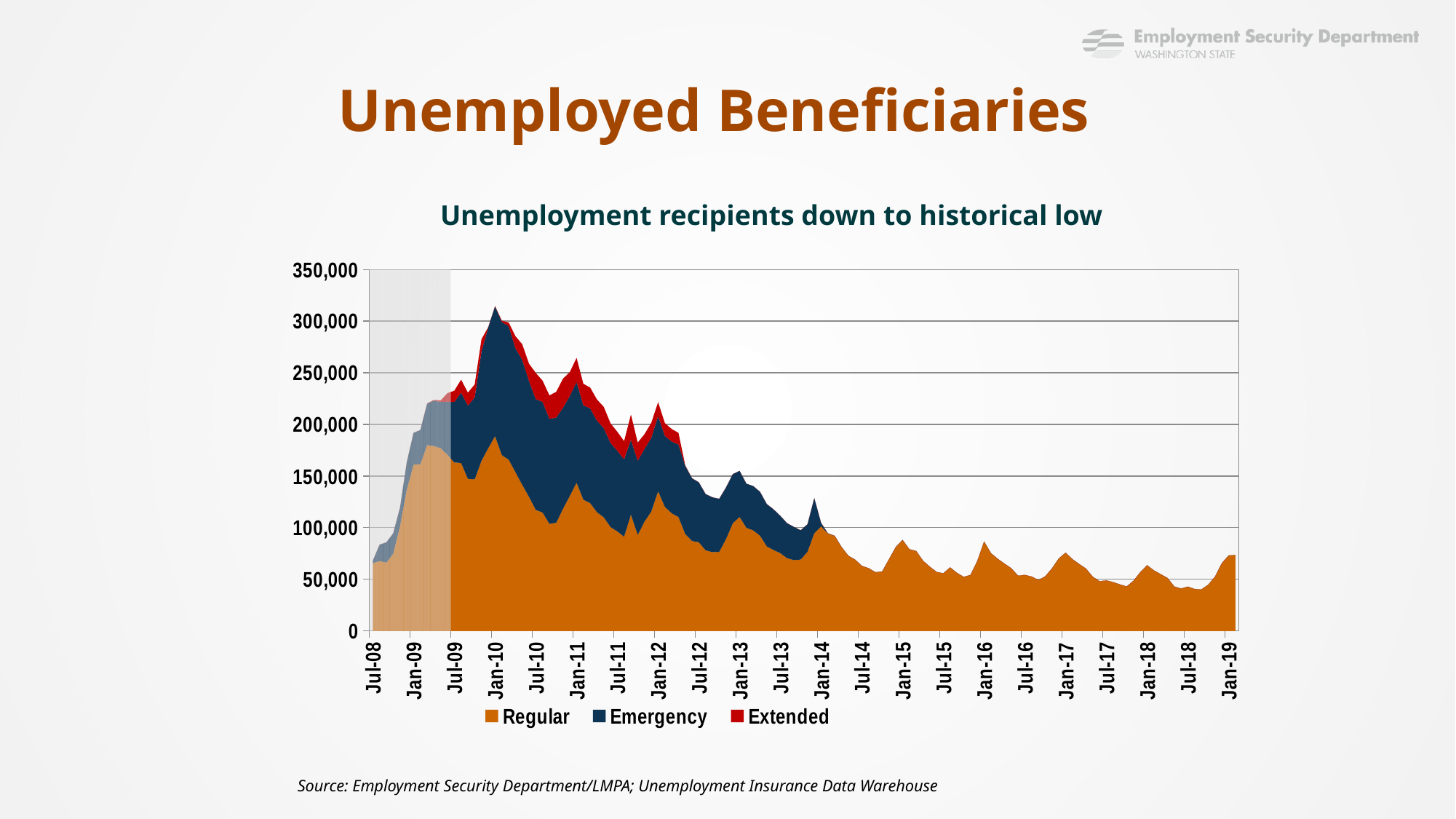
What is the title of the chart? Unemployment recipients down to historical low Is the total number of beneficiaries at Jan-10 greater or less than 250,000? greater Is the total number of beneficiaries at Jan-15 greater or less than 100,000? less Is the value for Regular beneficiaries at Jan-19 greater or less than 100,000? less How many series does the legend list? 3 What are the three series named in the legend? Regular, Emergency, Extended Which series is plotted at the bottom of the stack? Regular Which is larger: the total number of beneficiaries at Jan-10 or at Jan-19? Jan-10 What kind of chart is shown on the slide? Stacked area chart Do total beneficiaries generally rise or fall from Jan-10 to Jan-19? fall